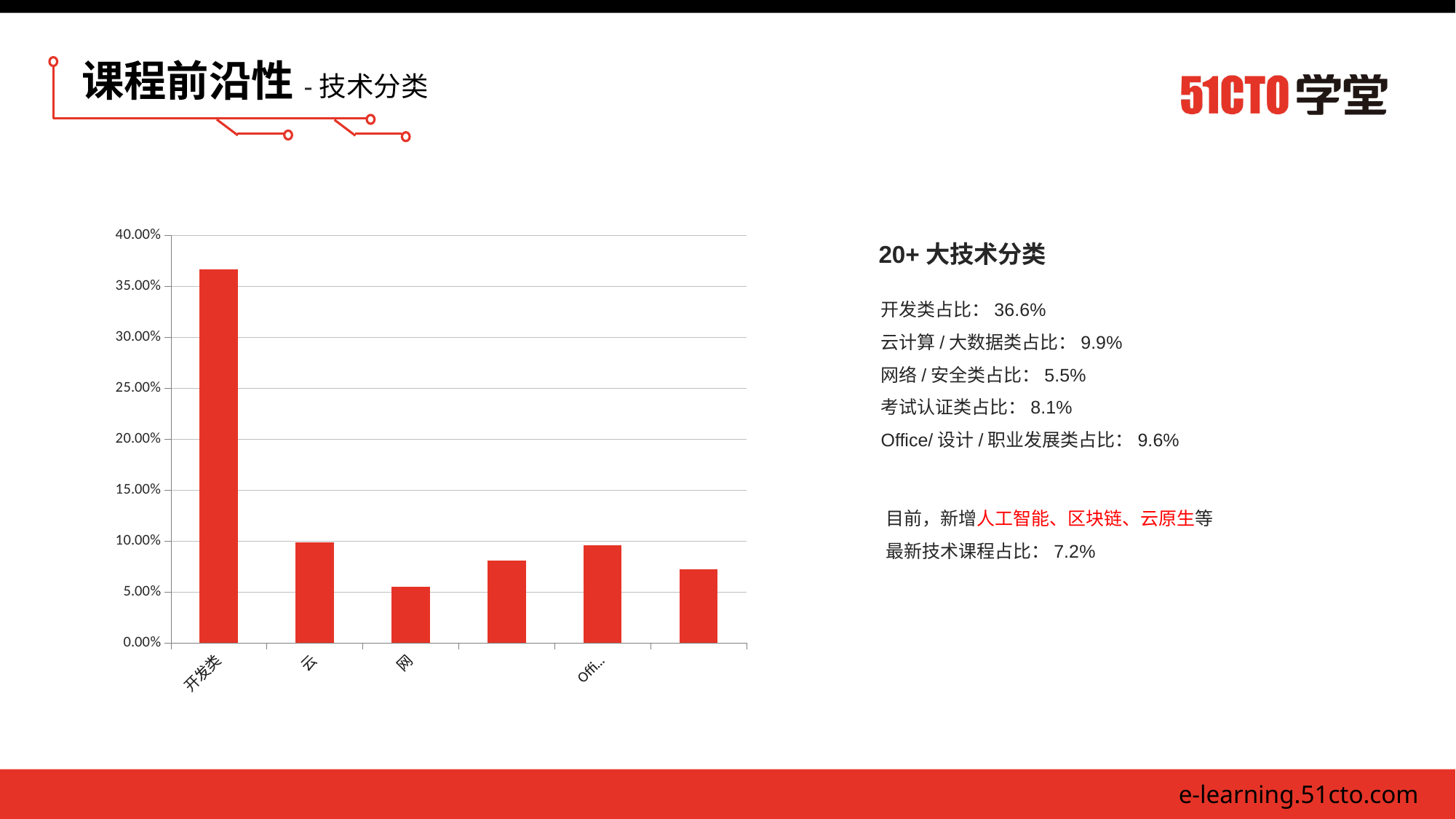
Which is larger, the value for 开发类 or the value for 云? 开发类 Is the value for 云 greater or less than 5.00%? greater How many bars are plotted in the chart? 6 Which category has the highest bar in the chart? 开发类 Is the value for Offi... greater or less than 5.00%? greater Is the value for 网 greater or less than 10.00%? less What kind of chart is shown on the slide? bar chart Which is larger, the value for 云 or the value for 网? 云 Which is larger, the value for Offi... or the value for 网? Offi... Which category has the lowest bar in the chart? 网 What is the highest value shown on the chart's vertical axis? 40.00%